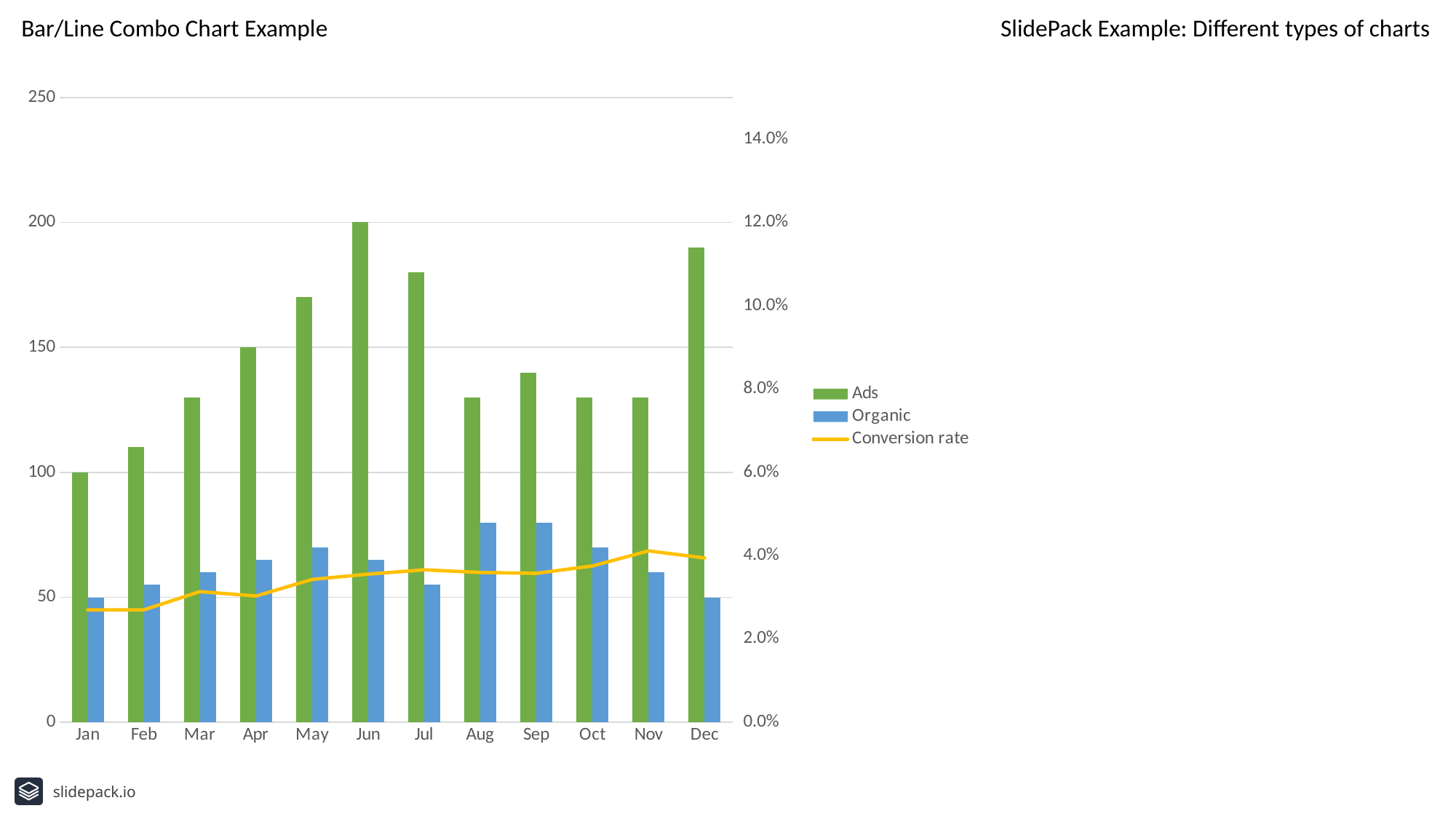
Is the Conversion rate for Jan greater or less than 4.0%? less What is the Ads value for Apr? 150 Which month has the highest Ads value? Jun How many months are shown on the x axis? 12 Which month has the lowest Ads value? Jan What is the Organic value for Jan? 50 Which is larger, the Ads value for Jun or the Ads value for Dec? Jun What is the difference between the Ads value for Jun and the Ads value for Jan? 100 What is the Ads value for Jan? 100 Is the Ads value for Dec greater or less than 150? greater What is the Ads value for Jun? 200 How many series does the legend list? 3